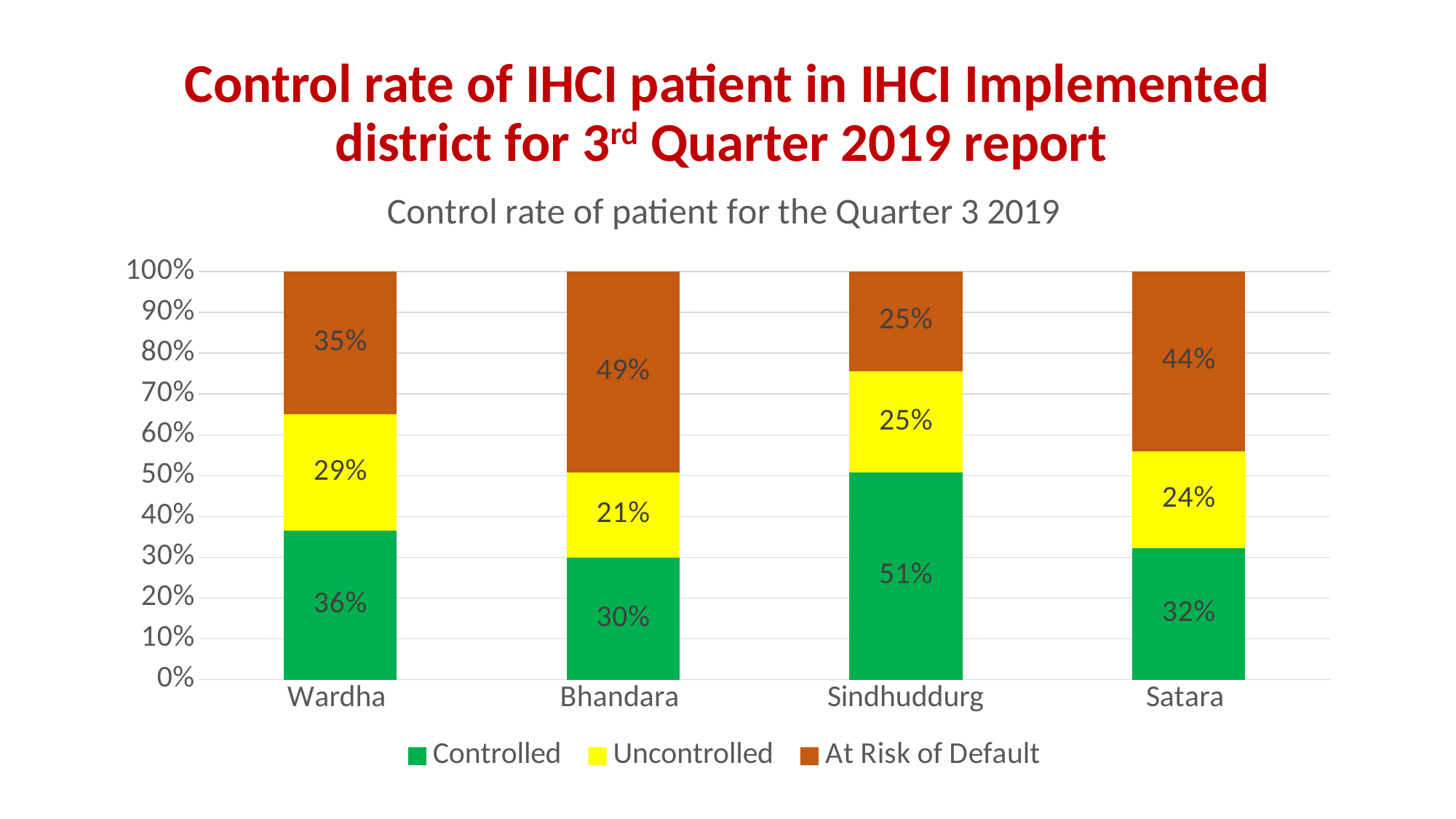
Which is larger, the Uncontrolled value for Wardha or the Uncontrolled value for Bhandara? Wardha Which district has the lowest At Risk of Default value? Sindhuddurg Which district has the highest Controlled value? Sindhuddurg Which colour represents the At Risk of Default series? Orange-brown What is the difference between the Controlled values for Sindhuddurg and Bhandara? 21% How many series does the legend list? 3 What is the total of the stacked bar for Wardha? 100% What is the At Risk of Default value for Bhandara? 49% What is the Controlled value for Sindhuddurg? 51% What kind of chart is shown on the slide? Stacked bar chart How many districts are shown on the x axis? 4 What is the Uncontrolled value for Satara? 24%